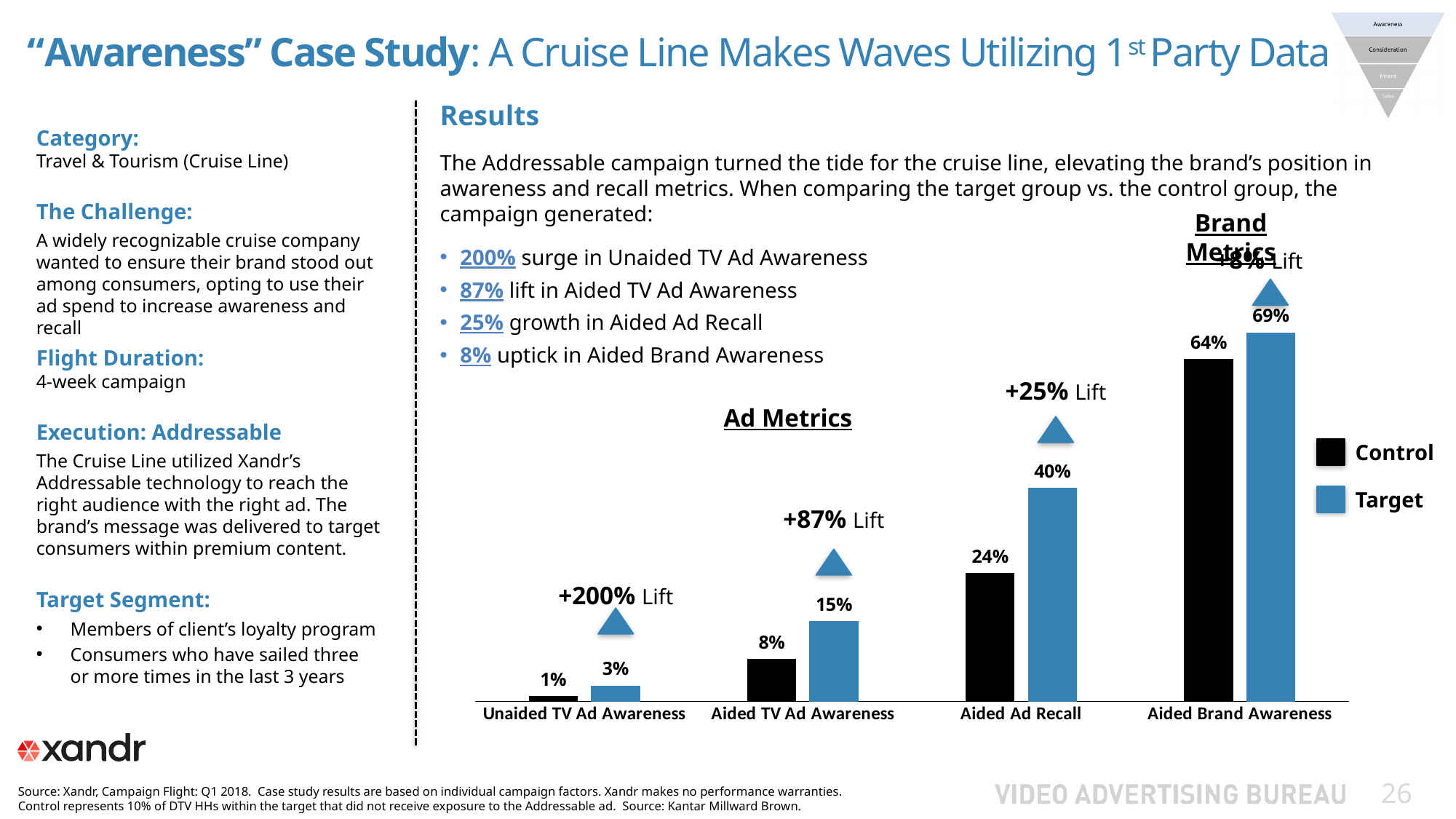
What lift is labelled above the Aided TV Ad Awareness bars? +87% Lift Which is larger for Aided TV Ad Awareness, the Control value or the Target value? Target What is the difference between the Target and Control values for Aided Ad Recall? 16% What is the Target value for Unaided TV Ad Awareness? 3% Which category has the highest Target value? Aided Brand Awareness Which category has the lowest Control value? Unaided TV Ad Awareness What kind of chart is shown on the slide? Bar chart What is the Control value for Aided Brand Awareness? 64% How many categories are shown on the x axis of the chart? 4 What is the Control value for Aided TV Ad Awareness? 8% What is the Target value for Aided Ad Recall? 40% How many series does the chart legend list? 2